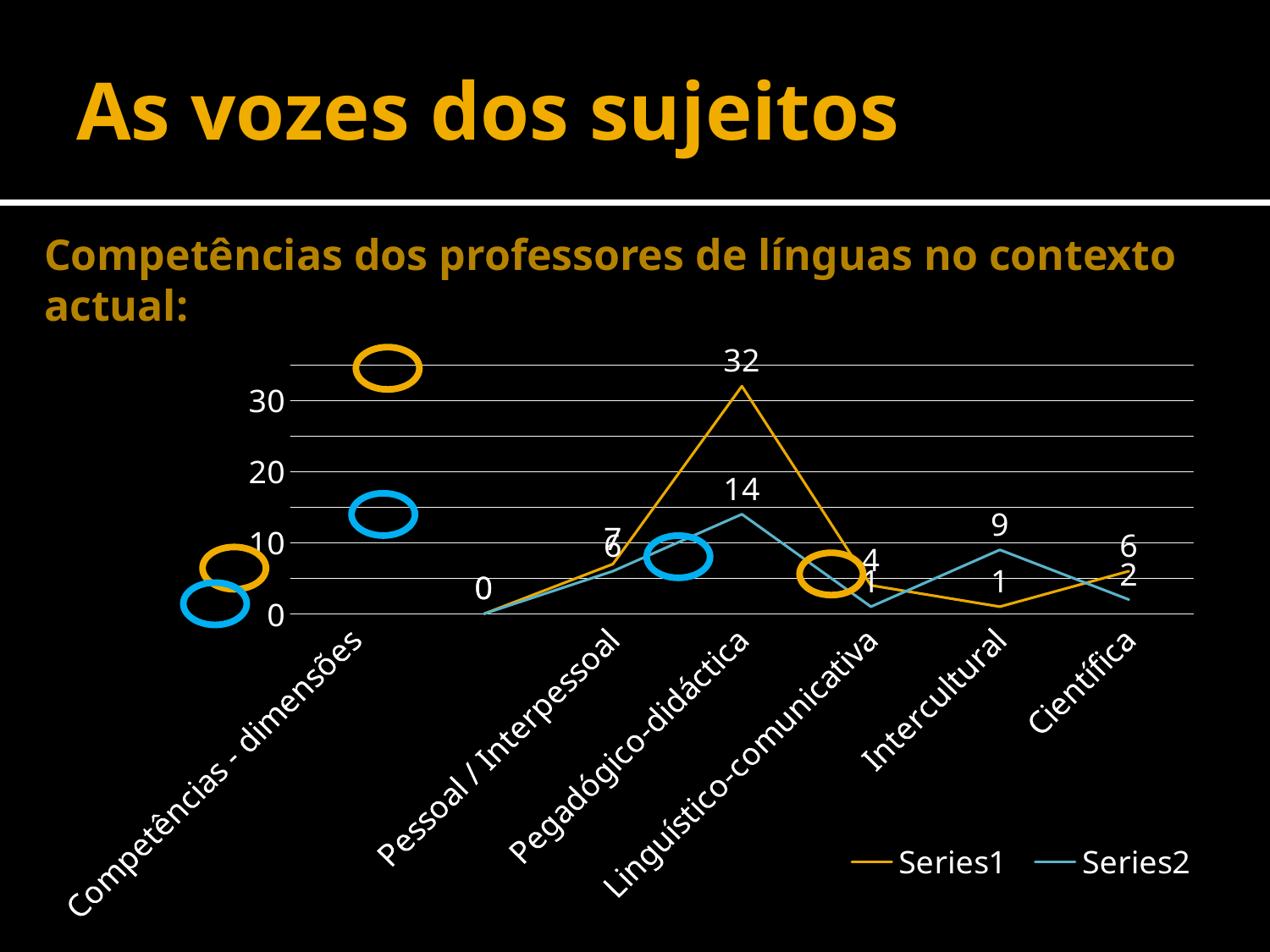
What is the value of Series2 for Pegadógico-didáctica? 14 Does Series1 rise or fall from Pegadógico-didáctica to Intercultural? fall How many series does the legend list? 2 Is the value of Series1 for Pegadógico-didáctica greater or less than 30? greater What is the value of Series2 for Intercultural? 9 What is the value of Series1 for Científica? 6 For which category does Series1 reach its highest value? Pegadógico-didáctica What is the difference between Series1 and Series2 for Pegadógico-didáctica? 18 For Intercultural, which series has the larger value, Series1 or Series2? Series2 What is the value of Series1 for Pegadógico-didáctica? 32 What is the difference between Series2 and Series1 for Intercultural? 8 What kind of chart is shown on the slide? line chart